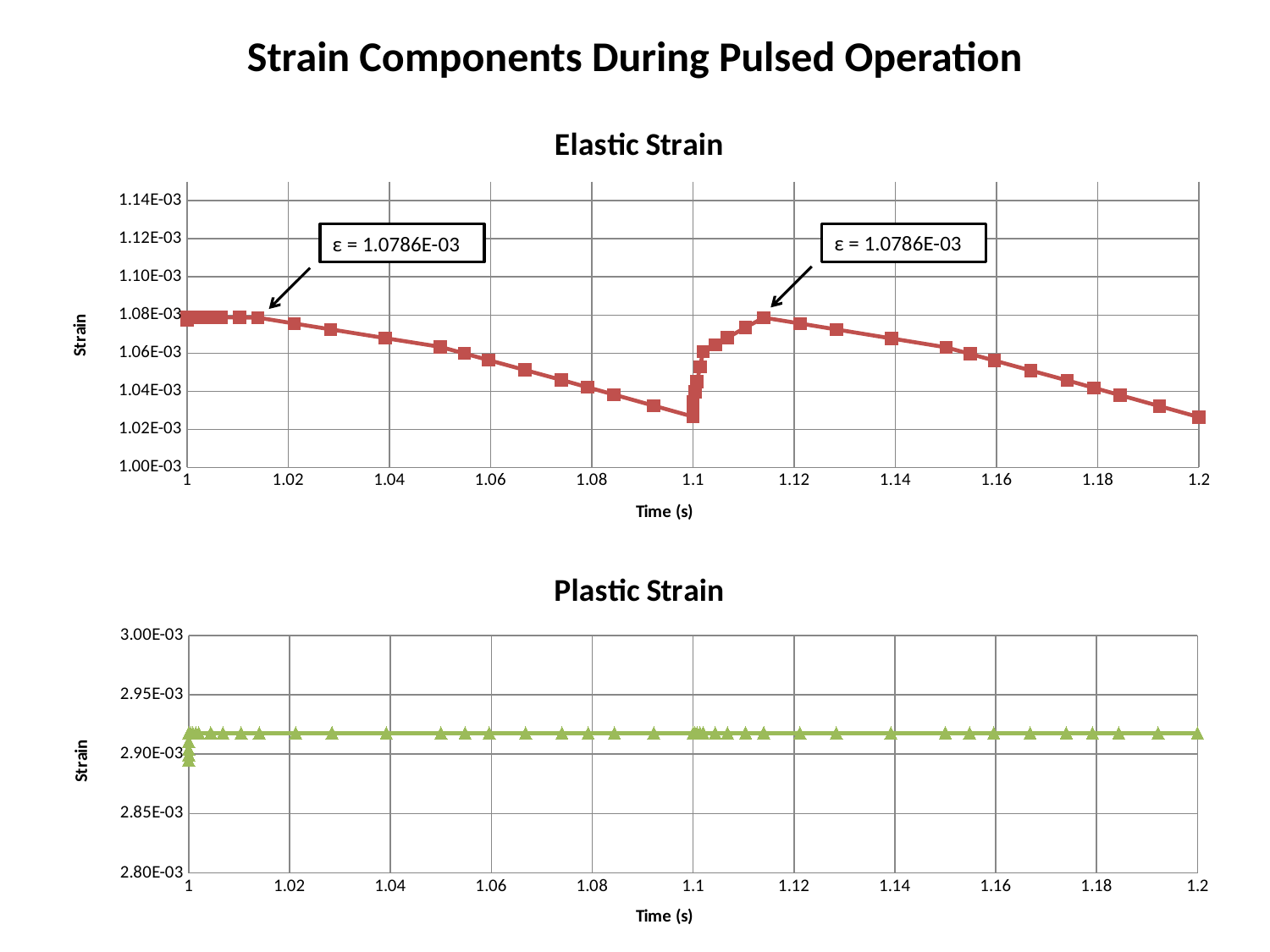
In the Elastic Strain chart, is the strain value at 1.06 s greater or less than 1.04E-03? greater In the Elastic Strain chart, what strain value is given in the annotation at the peak near 1.014 s? ε = 1.0786E-03 In the Elastic Strain chart, does the strain rise or fall between 1.12 s and 1.2 s? fall What is the x-axis title of the Plastic Strain chart? Time (s) In the Elastic Strain chart, is the strain value at 1.2 s greater or less than 1.04E-03? less In the Plastic Strain chart, is the strain value at 1.1 s greater or less than 2.90E-03? greater In the Elastic Strain chart, does the strain rise or fall between 1.02 s and 1.1 s? fall How many charts are shown on the slide? 2 In the Elastic Strain chart, what strain value is given in the annotation at the peak near 1.114 s? ε = 1.0786E-03 What kind of chart is the Elastic Strain chart? line chart